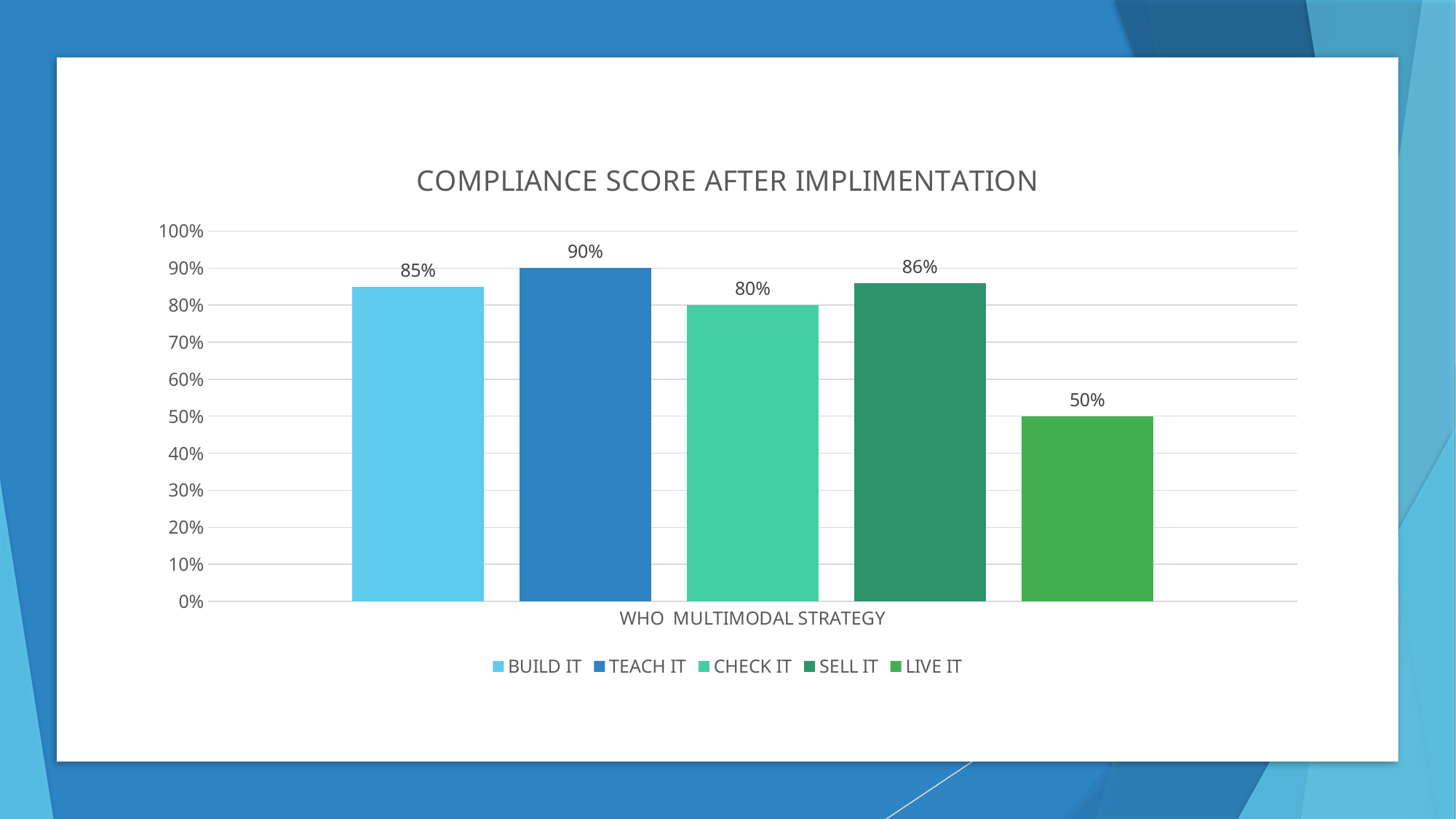
What is the compliance score for BUILD IT? 85% What kind of chart is shown on the slide? Bar chart What is the compliance score for LIVE IT? 50% What is the title of the chart? COMPLIANCE SCORE AFTER IMPLIMENTATION Which has a higher compliance score, SELL IT or CHECK IT? SELL IT Which series has the lowest compliance score? LIVE IT What is the difference between the compliance scores for TEACH IT and LIVE IT? 40% What is the difference between the compliance scores for SELL IT and CHECK IT? 6% How many series does the legend list? 5 Which series has the highest compliance score? TEACH IT Is the value for LIVE IT greater or less than 60%? less What is the compliance score for TEACH IT? 90%